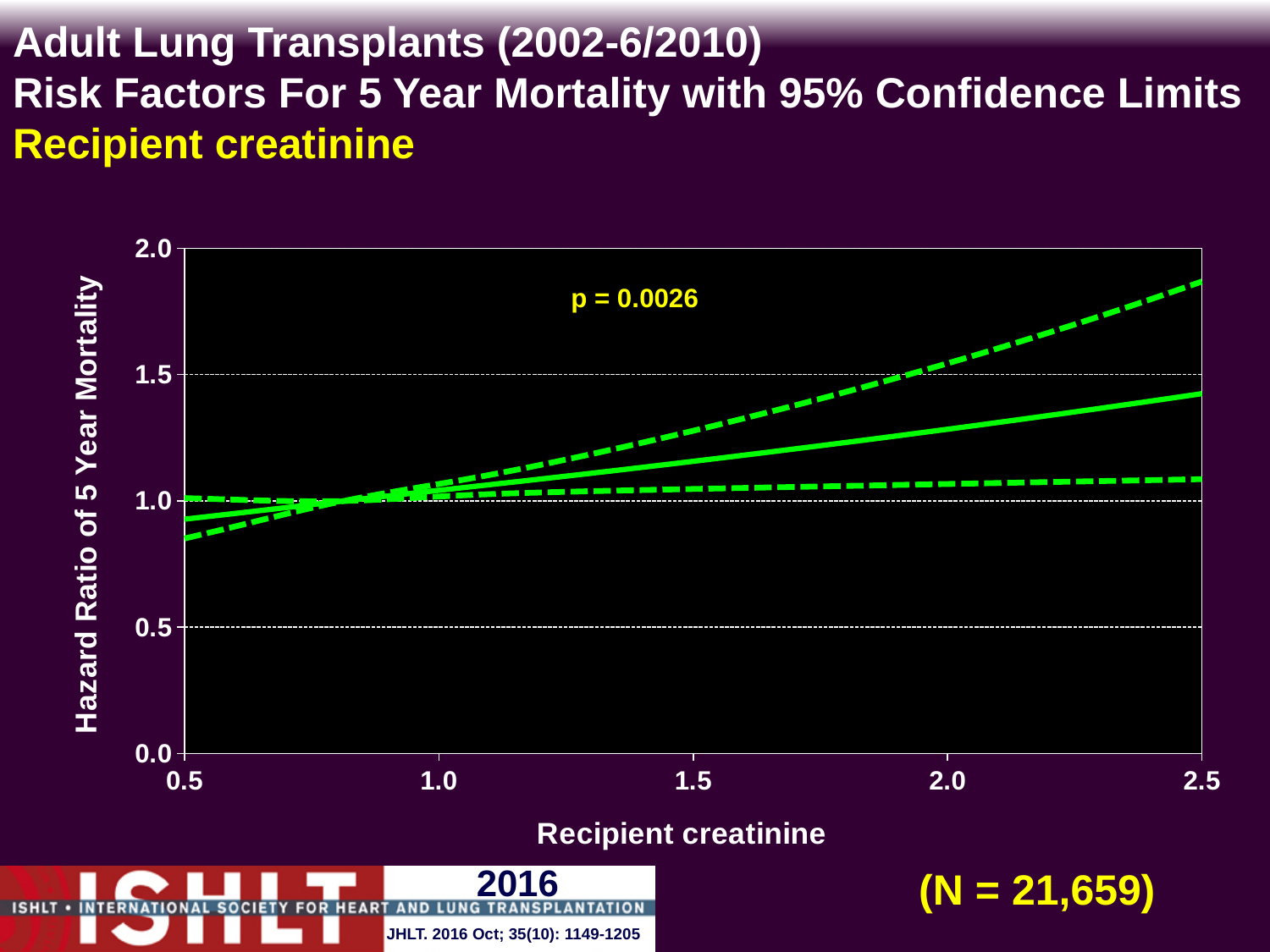
What is the sample size (N) shown on the slide? N = 21,659 Is the hazard ratio on the solid line at a recipient creatinine of 0.5 greater or less than 1.0? less Is the upper dashed confidence limit at a recipient creatinine of 2.5 greater or less than 1.5? greater How many lines are plotted on the chart? 3 Is the lower dashed confidence limit at a recipient creatinine of 0.5 greater or less than 1.0? less Does the solid hazard ratio line rise or fall as recipient creatinine increases from 0.5 to 2.5? rise What kind of chart is shown on the slide? line chart Which is larger at a recipient creatinine of 2.5: the upper dashed confidence limit or the solid hazard ratio line? the upper dashed confidence limit What is the p-value shown on the chart? p = 0.0026